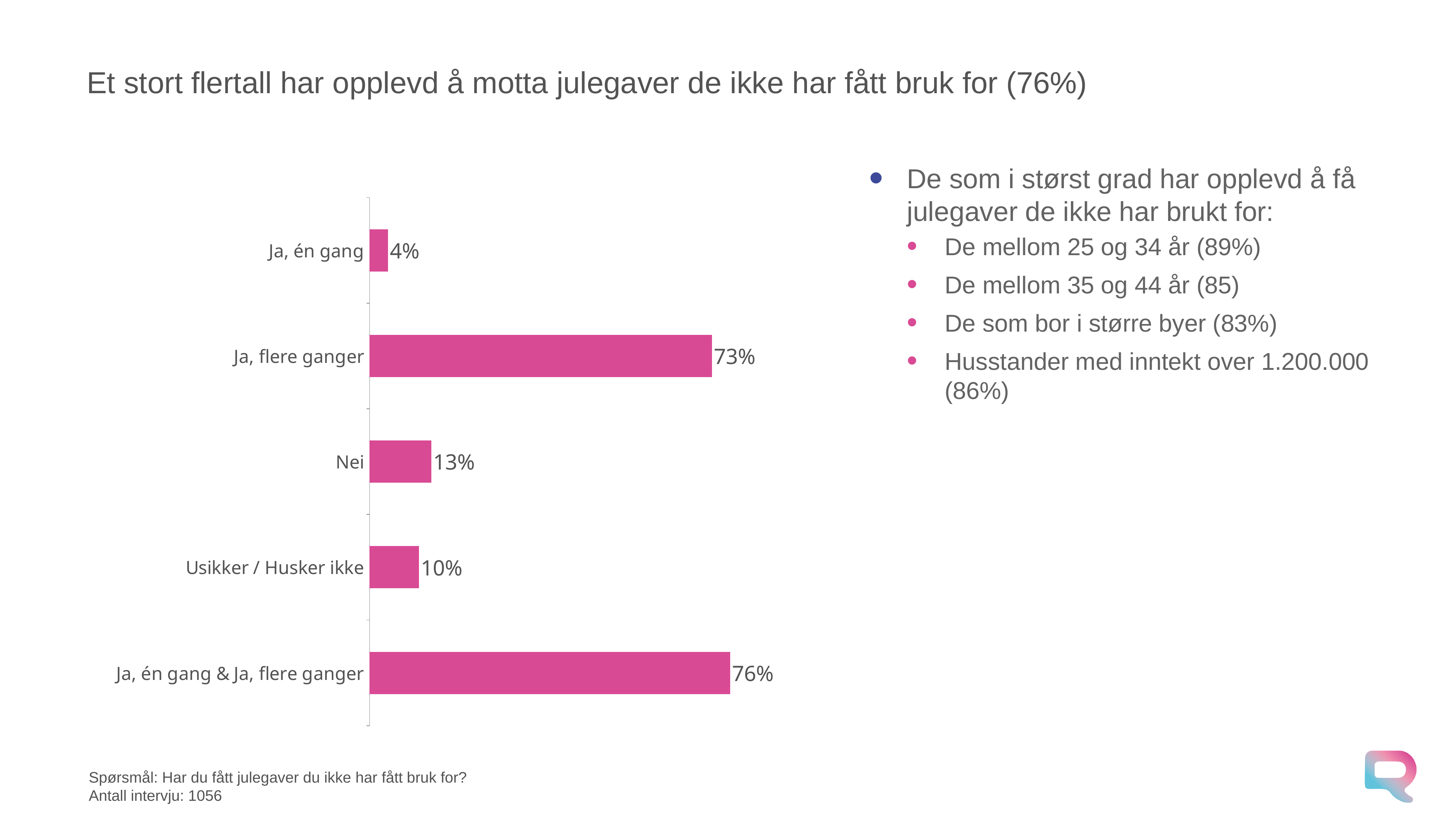
What is the value for "Ja, én gang"? 4% What is the value for "Nei"? 13% What kind of chart is shown on the slide? Bar chart What colour are the bars in the chart? Pink Which category has the highest value? Ja, én gang & Ja, flere ganger What is the difference between "Ja, flere ganger" and "Nei"? 60% What is the value for "Ja, flere ganger"? 73% What is the difference between "Nei" and "Usikker / Husker ikke"? 3% Which is larger, "Nei" or "Usikker / Husker ikke"? Nei Which category has the lowest value? Ja, én gang How many categories are shown in the chart? 5 What is the value for "Usikker / Husker ikke"? 10%